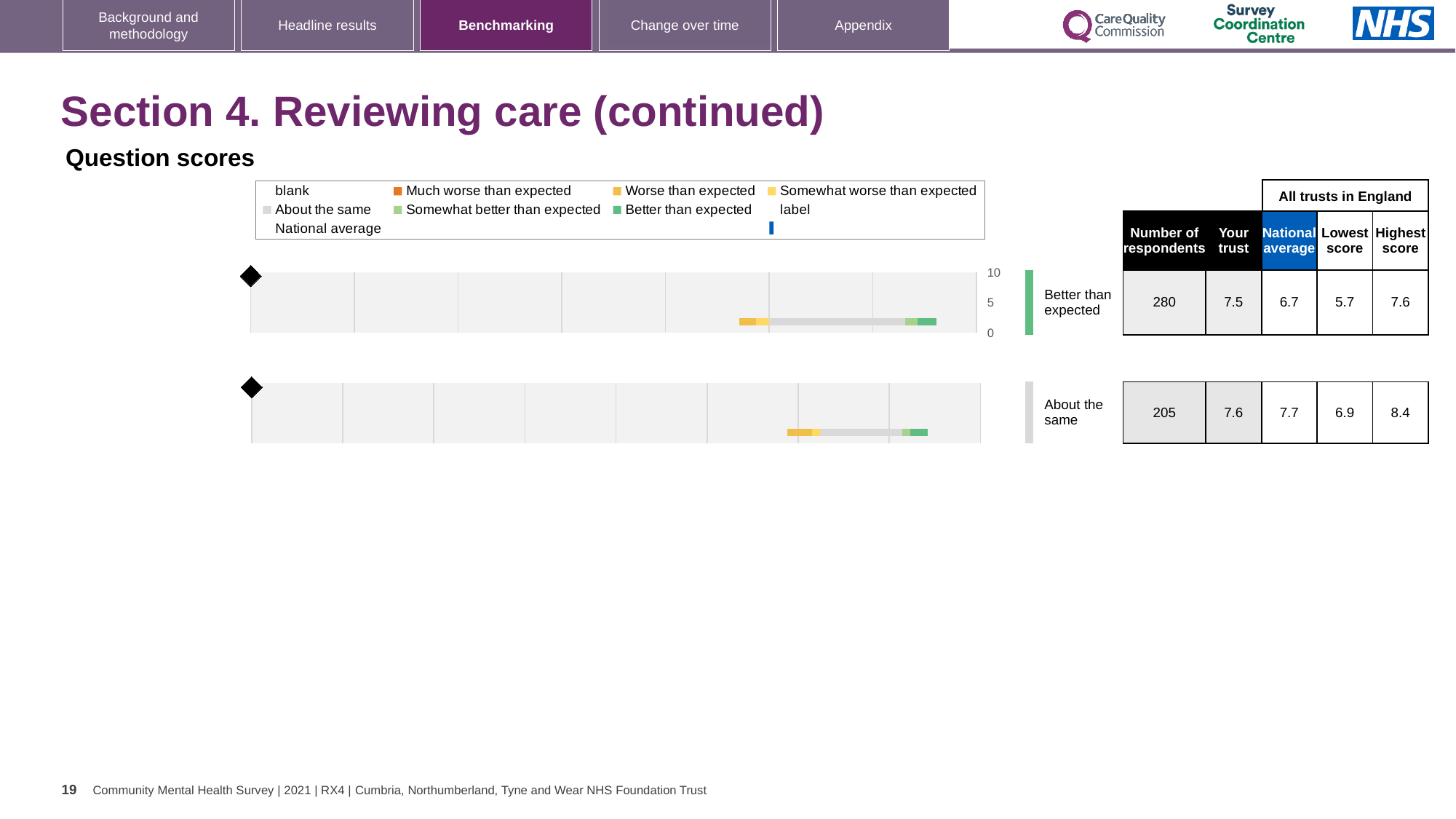
For the bottom chart (About the same), what is the difference between the highest score and the lowest score? 1.5 For the bottom chart (About the same), what is the lowest score among all trusts in England? 6.9 What kind of chart is used on this slide to show the question scores? bar chart For the top chart (Better than expected), which is higher: the Your trust score or the national average? Your trust For the top chart (Better than expected), what is the difference between the highest score and the lowest score? 1.9 For the bottom chart (About the same), what is the Your trust score? 7.6 For the top chart (Better than expected), what is the number of respondents? 280 What benchmark category label is shown next to the bottom chart? About the same For the top chart (Better than expected), what is the national average score? 6.7 What is the highest tick value shown on the vertical axis of the top chart? 10 Which of the two charts has the larger number of respondents? Better than expected How many question charts are shown on the slide? 2